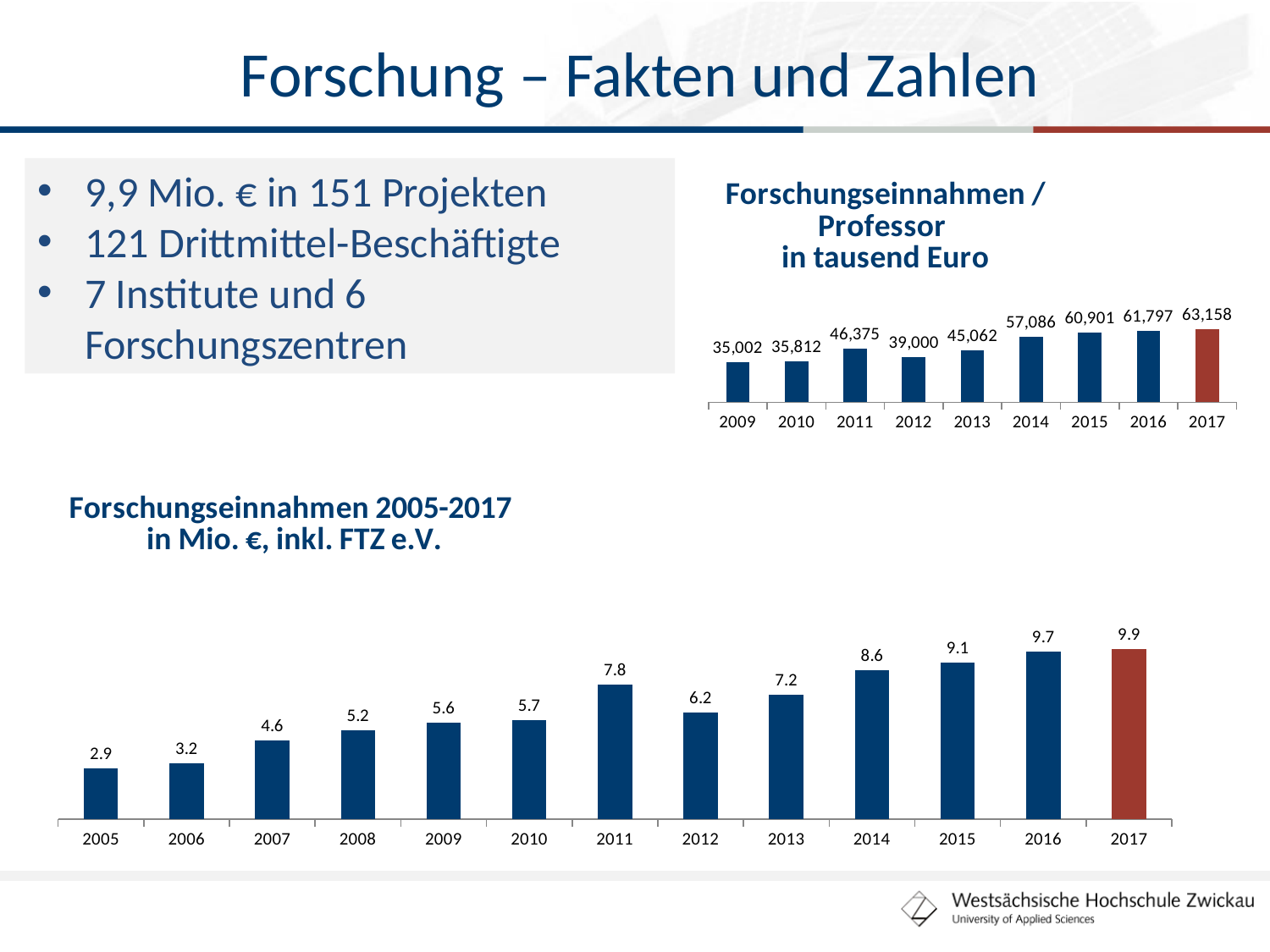
In the chart 'Forschungseinnahmen 2005-2017 in Mio. €, inkl. FTZ e.V.', what is the value for 2011? 7.8 In the chart 'Forschungseinnahmen / Professor in tausend Euro', what is the value for 2014? 57,086 In the chart 'Forschungseinnahmen 2005-2017 in Mio. €, inkl. FTZ e.V.', which is larger, the value for 2011 or the value for 2012? 2011 How many years are shown in the chart 'Forschungseinnahmen / Professor in tausend Euro'? 9 What kind of chart is 'Forschungseinnahmen 2005-2017 in Mio. €, inkl. FTZ e.V.'? Bar chart In the chart 'Forschungseinnahmen 2005-2017 in Mio. €, inkl. FTZ e.V.', what is the difference between the values for 2017 and 2005? 7.0 How many years are shown in the chart 'Forschungseinnahmen 2005-2017 in Mio. €, inkl. FTZ e.V.'? 13 In the chart 'Forschungseinnahmen 2005-2017 in Mio. €, inkl. FTZ e.V.', which year has the lowest value? 2005 In the chart 'Forschungseinnahmen / Professor in tausend Euro', which is larger, the value for 2011 or the value for 2012? 2011 In the chart 'Forschungseinnahmen 2005-2017 in Mio. €, inkl. FTZ e.V.', which year has the highest value? 2017 In the chart 'Forschungseinnahmen / Professor in tausend Euro', which year has the lowest value? 2009 In the chart 'Forschungseinnahmen / Professor in tausend Euro', what colour is the bar for 2017? Red